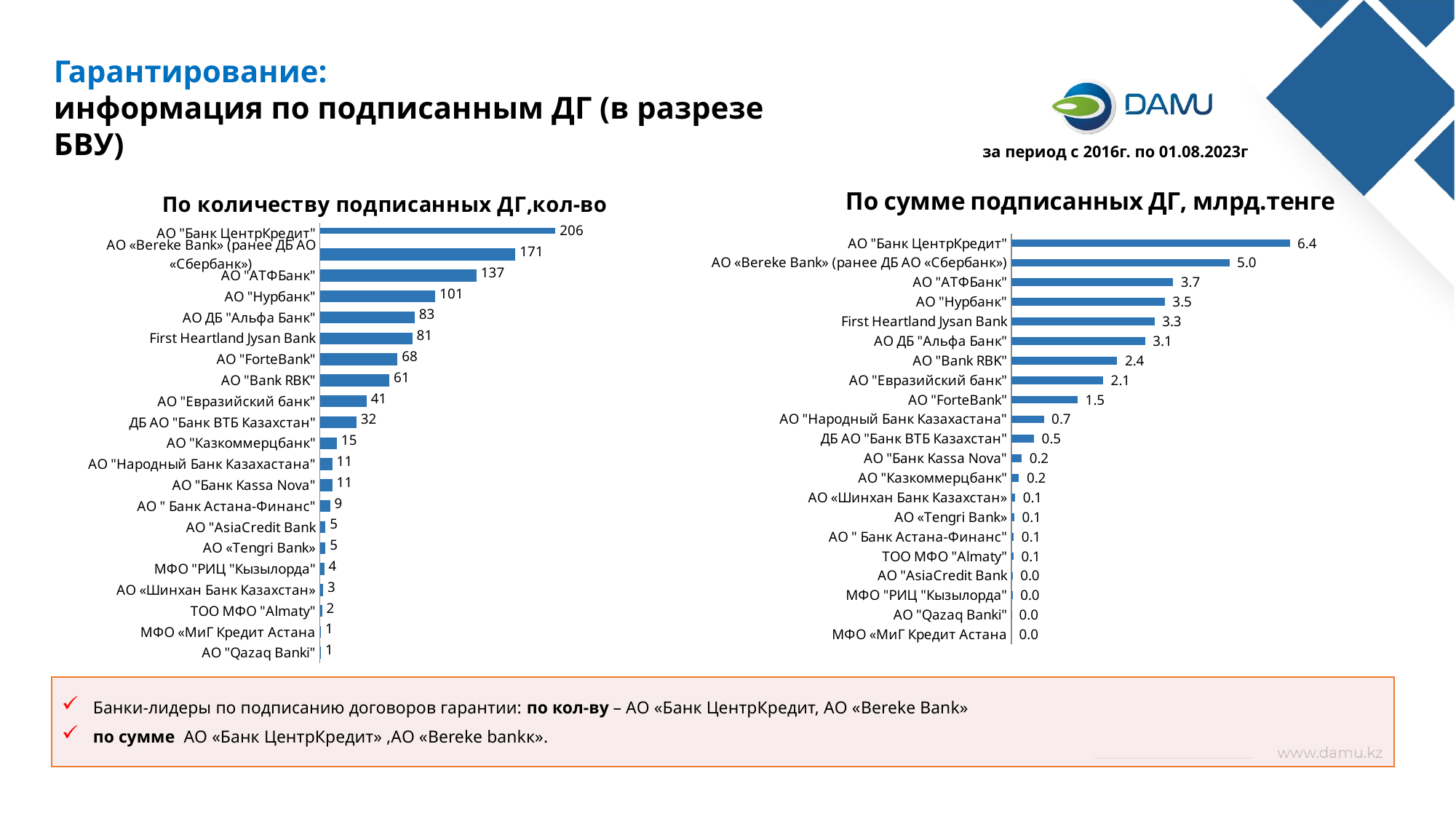
On the chart "По сумме подписанных ДГ, млрд.тенге", what is the value for АО "Bank RBK"? 2.4 What type of chart is "По сумме подписанных ДГ, млрд.тенге"? Bar chart On the chart "По сумме подписанных ДГ, млрд.тенге", what is the value for АО "ForteBank"? 1.5 On the chart "По количеству подписанных ДГ,кол-во", which is larger: АО "ForteBank" or АО "Bank RBK"? АО "ForteBank" On the chart "По количеству подписанных ДГ,кол-во", which bank has the highest value? АО "Банк ЦентрКредит" On the chart "По сумме подписанных ДГ, млрд.тенге", what is the difference between АО "АТФБанк" and АО "Нурбанк"? 0.2 On the chart "По количеству подписанных ДГ,кол-во", what is the difference between АО "Банк ЦентрКредит" and АО «Bereke Bank» (ранее ДБ АО «Сбербанк»)? 35 On the chart "По количеству подписанных ДГ,кол-во", what is the value for АО "АТФБанк"? 137 On the chart "По количеству подписанных ДГ,кол-во", what is the value for ДБ АО "Банк ВТБ Казахстан"? 32 How many banks are shown on the chart "По количеству подписанных ДГ,кол-во"? 21 On the chart "По сумме подписанных ДГ, млрд.тенге", which bank has the highest value? АО "Банк ЦентрКредит" On the chart "По сумме подписанных ДГ, млрд.тенге", which is larger: First Heartland Jysan Bank or АО ДБ "Альфа Банк"? First Heartland Jysan Bank